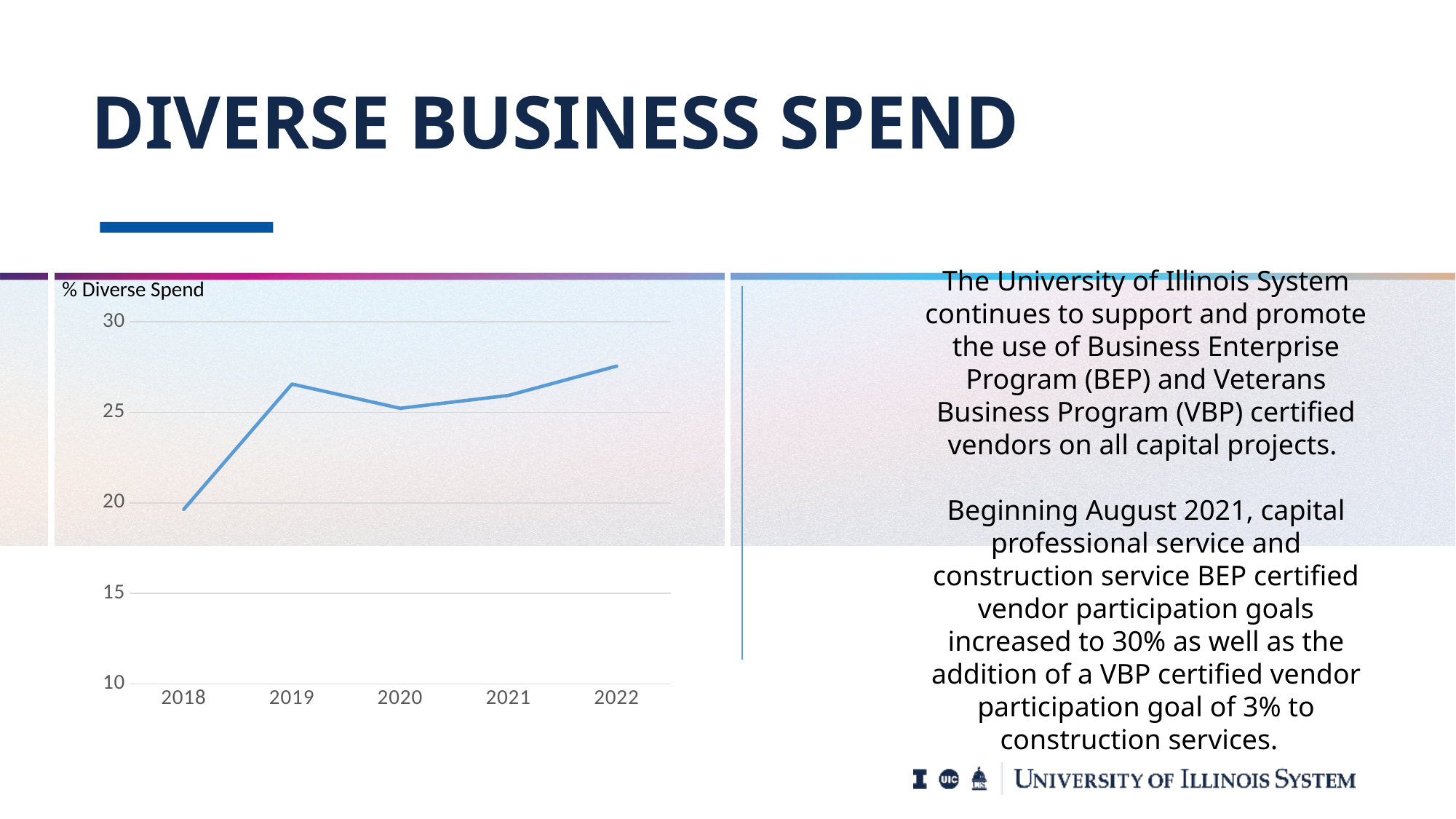
Which year has the lowest % Diverse Spend? 2018 Is the value for 2019 greater or less than 25? greater Does the % Diverse Spend rise or fall from 2019 to 2020? fall Is the value for 2021 greater or less than 25? greater Which year has the highest % Diverse Spend? 2022 Which year has a higher % Diverse Spend, 2018 or 2019? 2019 What is the title of the chart? % Diverse Spend Which year has a higher % Diverse Spend, 2020 or 2022? 2022 Is the value for 2022 greater or less than 30? less How many years are plotted on the x axis of the chart? 5 What kind of chart is shown on the slide? line chart